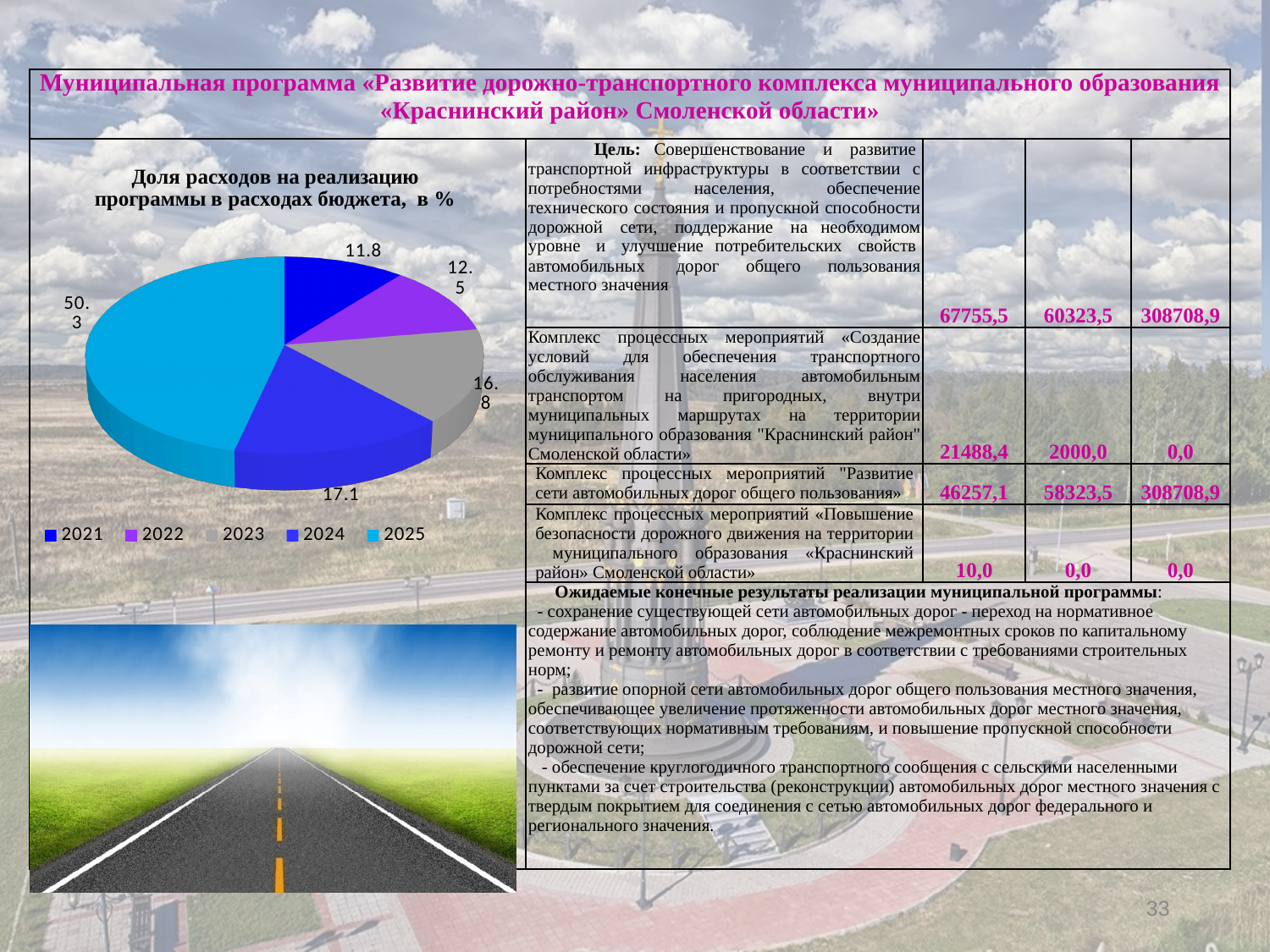
What is the difference between the values for 2025 and 2024 in the pie chart? 33.2 Which is larger in the pie chart, the value for 2023 or the value for 2022? 2023 How many entries does the legend of the pie chart list? 5 What is the value for 2022 in the pie chart? 12.5 What is the value for 2023 in the pie chart? 16.8 Which year has the smallest slice in the pie chart? 2021 What type of chart is shown on the slide? Pie chart How many slices does the pie chart have? 5 What is the value for 2025 in the pie chart? 50.3 Which year has the largest slice in the pie chart? 2025 What is the title of the chart on the slide? Доля расходов на реализацию программы в расходах бюджета, в % What is the value for 2021 in the pie chart? 11.8